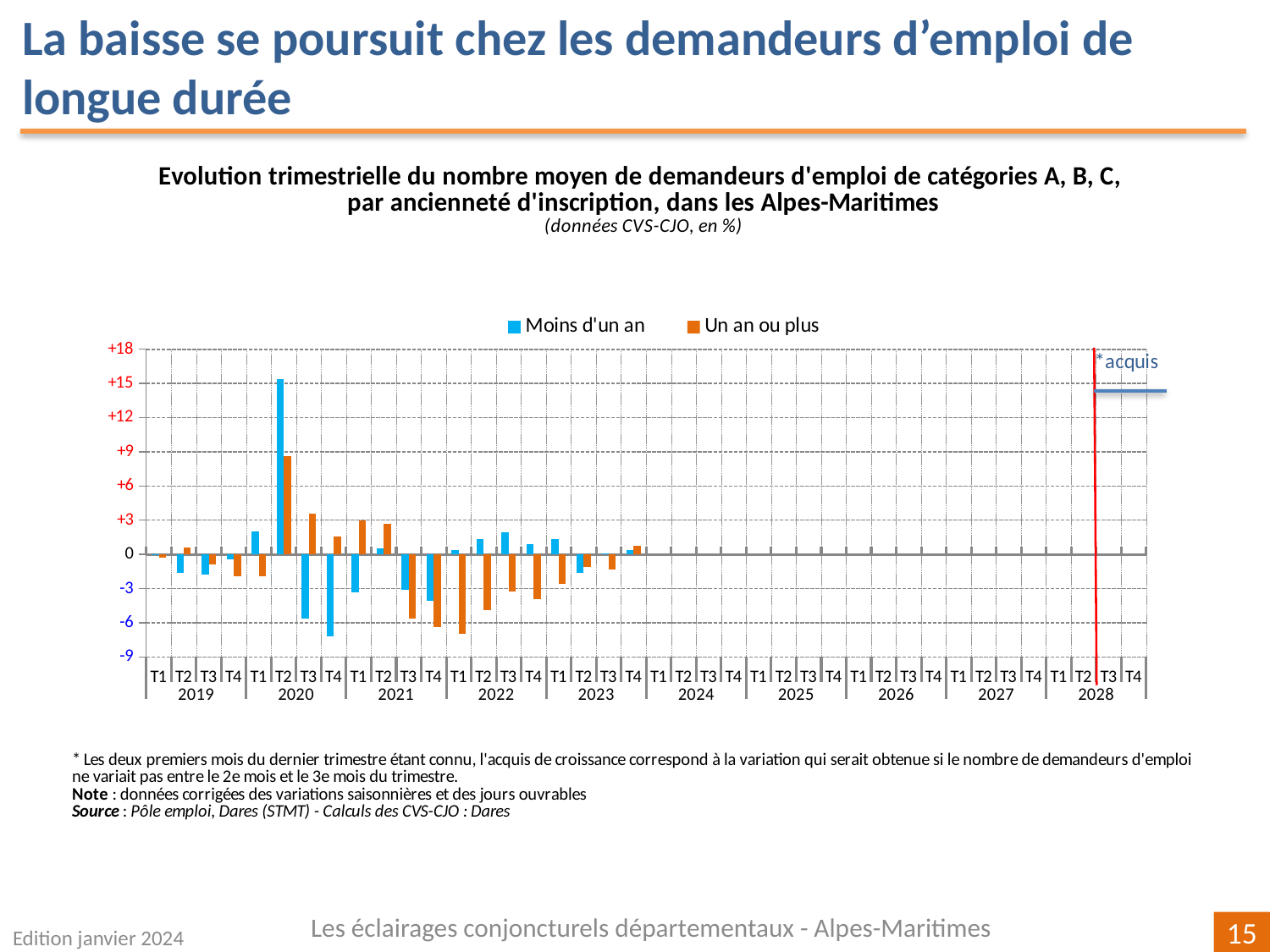
In T3 2020, which series has the larger value, 'Moins d'un an' or 'Un an ou plus'? Un an ou plus In which quarter does the 'Moins d'un an' series reach its highest value? T2 2020 Is the value for 'Moins d'un an' in T4 2020 greater or less than -6? less What are the two series named in the legend? Moins d'un an; Un an ou plus In T1 2022, which series has the larger value, 'Moins d'un an' or 'Un an ou plus'? Moins d'un an In T2 2020, which series has the larger value, 'Moins d'un an' or 'Un an ou plus'? Moins d'un an Is the value for 'Moins d'un an' in T2 2020 greater or less than +12? greater What kind of chart is shown on the slide? bar chart How many years are labelled along the x axis? 10 Which series is drawn in orange? Un an ou plus How many series does the legend list? 2 Is the value for 'Un an ou plus' in T2 2020 greater or less than +6? greater